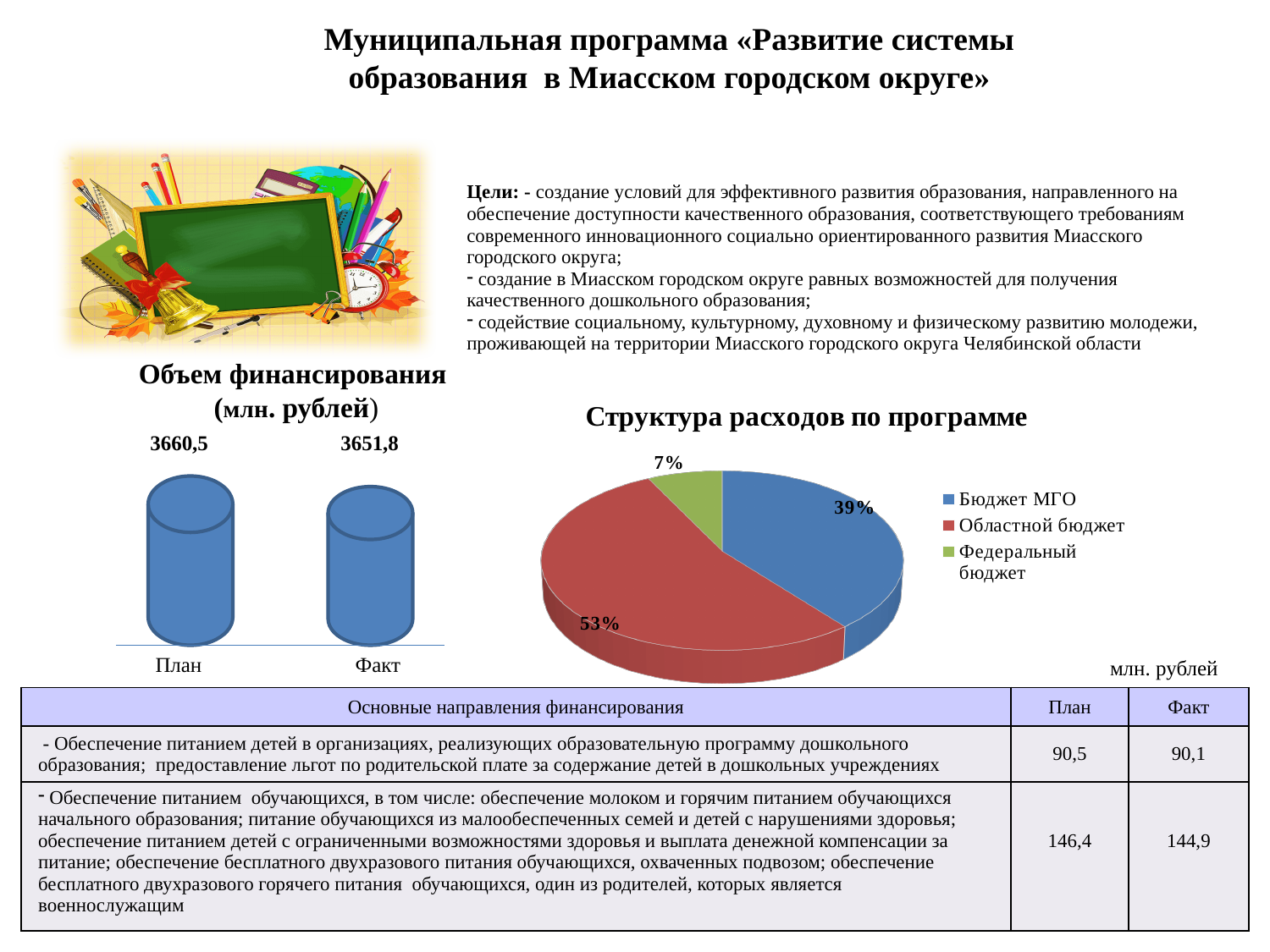
In the chart «Структура расходов по программе», what share does Бюджет МГО have? 39% In the chart «Структура расходов по программе», what share does Федеральный бюджет have? 7% How many entries does the legend of the chart «Структура расходов по программе» list? 3 In the chart «Объем финансирования (млн. рублей)», what is the difference between План and Факт? 8,7 In the chart «Структура расходов по программе», which budget has the smallest share? Федеральный бюджет How many categories are shown in the chart «Объем финансирования (млн. рублей)»? 2 In the chart «Структура расходов по программе», which budget has the largest share? Областной бюджет What kind of chart is «Объем финансирования (млн. рублей)»? Bar chart In the chart «Объем финансирования (млн. рублей)», what is the value for План? 3660,5 In the chart «Объем финансирования (млн. рублей)», which category has the higher value, План or Факт? План In the chart «Структура расходов по программе», what share does Областной бюджет have? 53% In the chart «Объем финансирования (млн. рублей)», what is the value for Факт? 3651,8